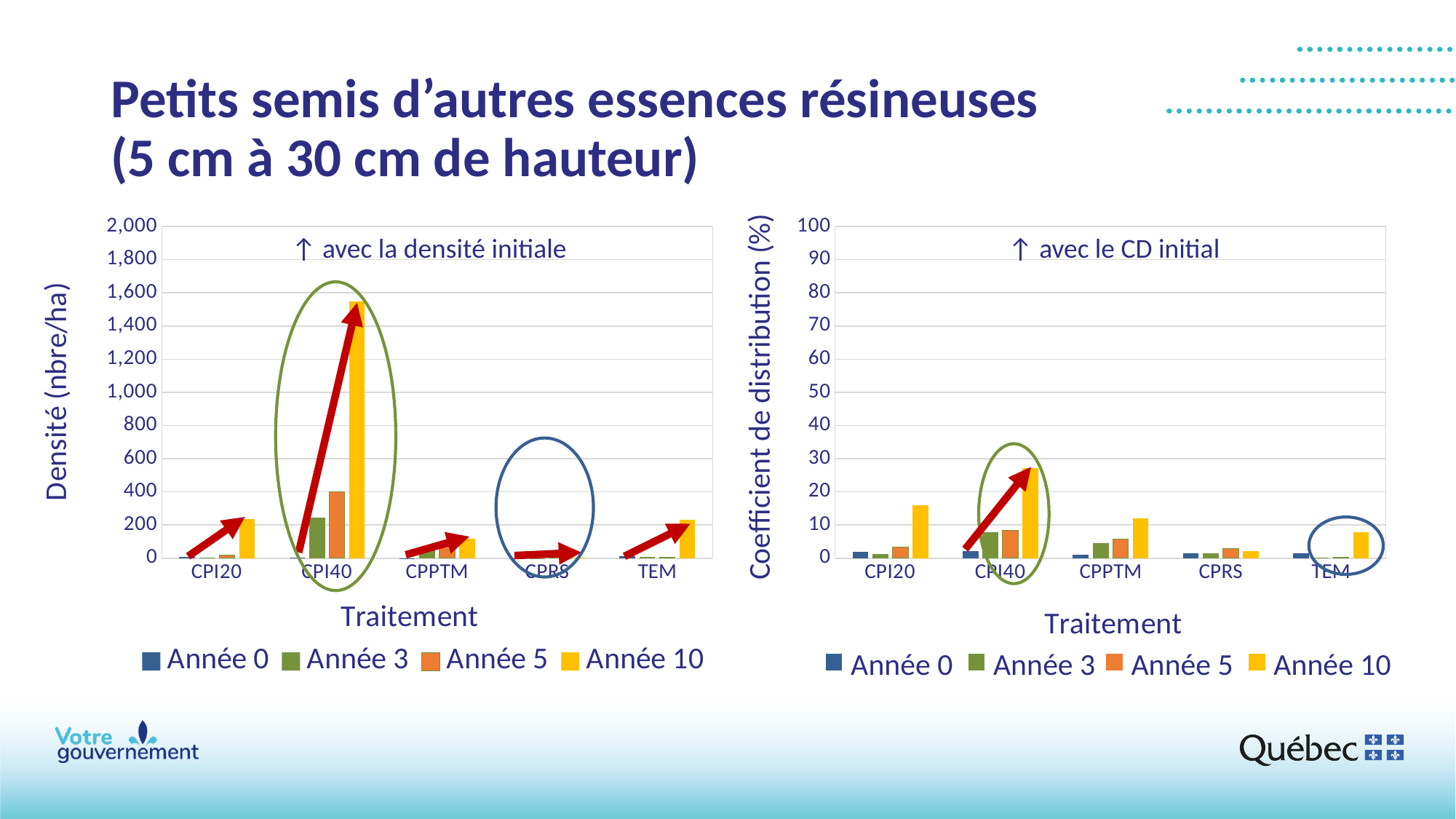
In the right chart (Coefficient de distribution), is the Année 10 value for CPI40 greater or less than 20? greater What is the y-axis title of the left chart? Densité (nbre/ha) In the right chart (Coefficient de distribution), is the Année 10 value for TEM greater or less than 10? less In the right chart (Coefficient de distribution), which is larger for Année 10: CPI20 or CPRS? CPI20 In the left chart (Densité), which treatment has the highest Année 10 bar? CPI40 In the left chart (Densité), is the Année 10 value for CPI40 greater or less than 1,400? greater In the right chart (Coefficient de distribution), which treatment has the highest Année 10 bar? CPI40 In the left chart (Densité), which treatment has the lowest Année 10 bar? CPRS How many series does the legend of the right chart (Coefficient de distribution) list? 4 What kind of chart is the left chart (Densité)? bar chart How many treatment categories are shown on the x axis of the left chart (Densité)? 5